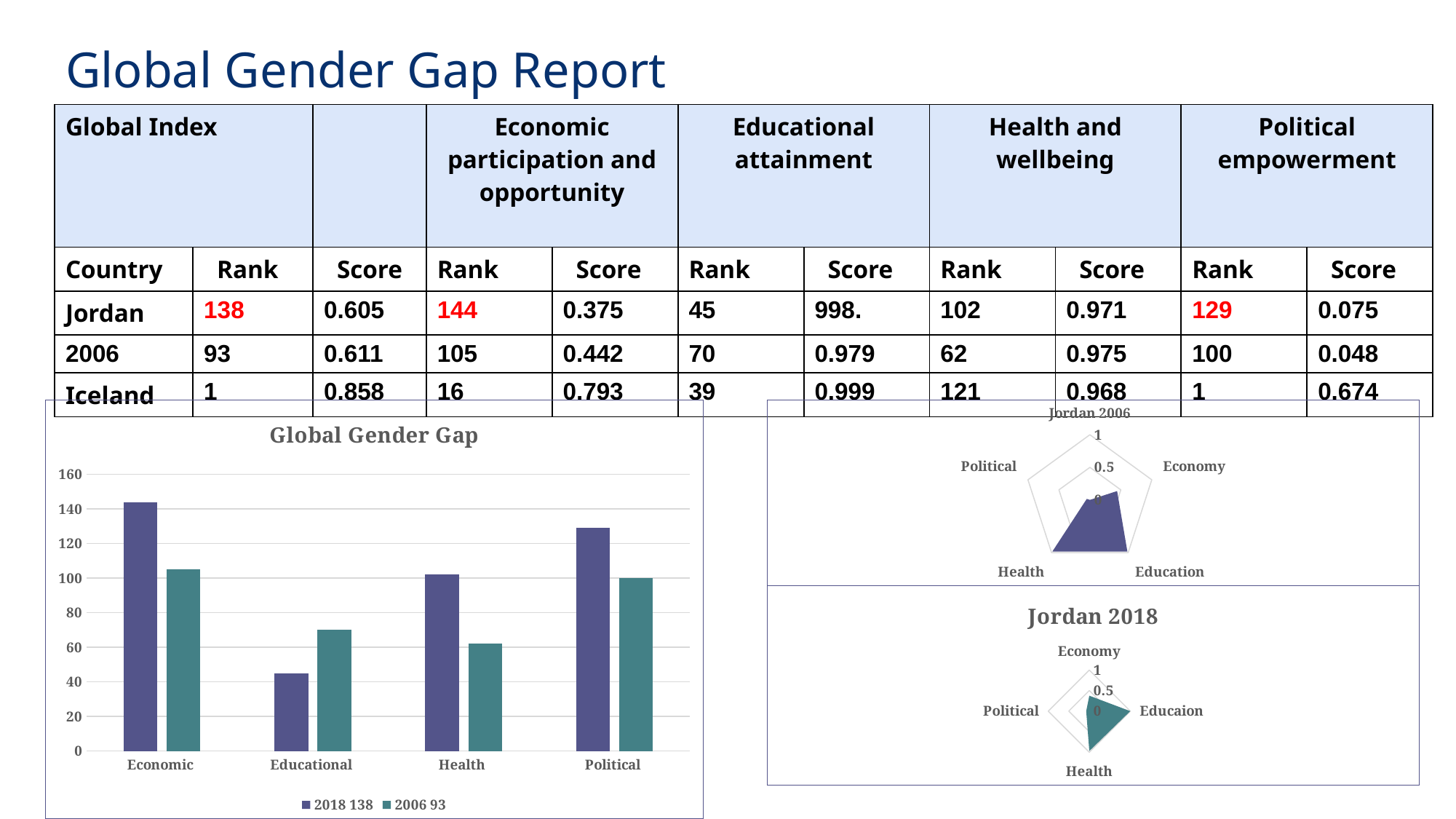
In the 'Global Gender Gap' bar chart, is the '2018 138' value for Educational greater or less than 60? less In the 'Global Gender Gap' bar chart, is the '2018 138' value for Economic greater or less than 140? greater In the 'Global Gender Gap' bar chart, which is larger for Health: the '2018 138' bar or the '2006 93' bar? 2018 138 How many series does the legend of the 'Global Gender Gap' bar chart list? 2 In the 'Global Gender Gap' bar chart, which category has the lowest value for the '2018 138' series? Educational In the 'Global Gender Gap' bar chart, which category has the lowest value for the '2006 93' series? Health What kind of chart is the 'Global Gender Gap' chart on the left of the slide? bar chart What are the two legend entries of the 'Global Gender Gap' bar chart? 2018 138 and 2006 93 In the 'Global Gender Gap' bar chart, which category has the highest value for the '2018 138' series? Economic In the 'Jordan 2018' radar chart, is the value for Political greater or less than 0.5? less How many categories are shown on the x axis of the 'Global Gender Gap' bar chart? 4 In the 'Global Gender Gap' bar chart, which is larger for Educational: the '2018 138' bar or the '2006 93' bar? 2006 93